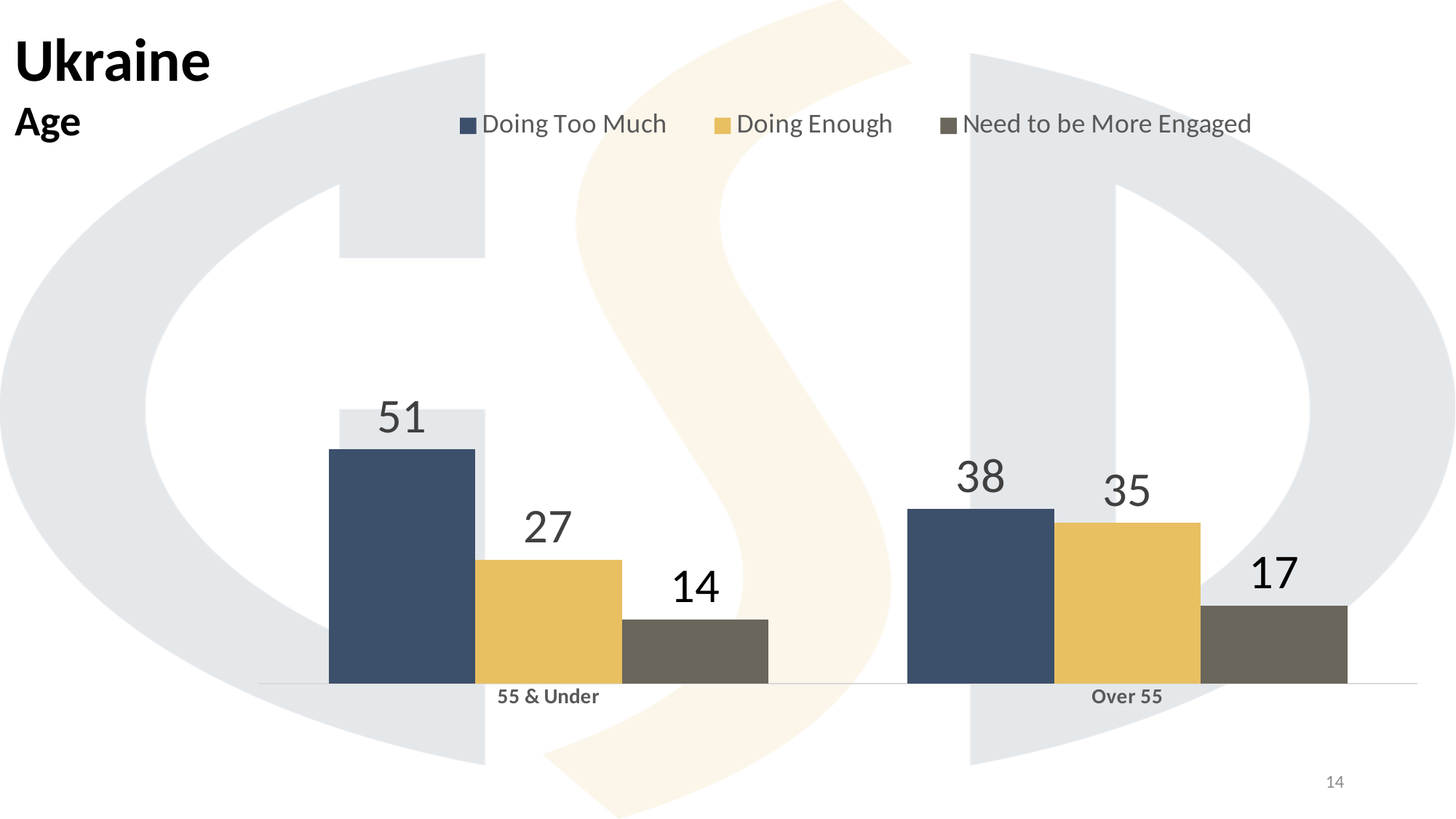
Which colour represents the "Doing Enough" series? Yellow What is the value for "Need to be More Engaged" in the "55 & Under" group? 14 What is the difference between "Doing Too Much" for "55 & Under" and "Doing Too Much" for "Over 55"? 13 What is the value for "Doing Enough" in the "Over 55" group? 35 Which series has the lowest value in the "55 & Under" group? Need to be More Engaged What is the value for "Doing Too Much" in the "55 & Under" group? 51 How many age categories are shown on the x axis? 2 Which series has the highest value in the "Over 55" group? Doing Too Much How many series does the legend list? 3 Which is larger: "Doing Enough" for "55 & Under" or "Doing Enough" for "Over 55"? Over 55 What is the difference between "Doing Enough" and "Need to be More Engaged" in the "Over 55" group? 18 What kind of chart is shown on the slide? Bar chart